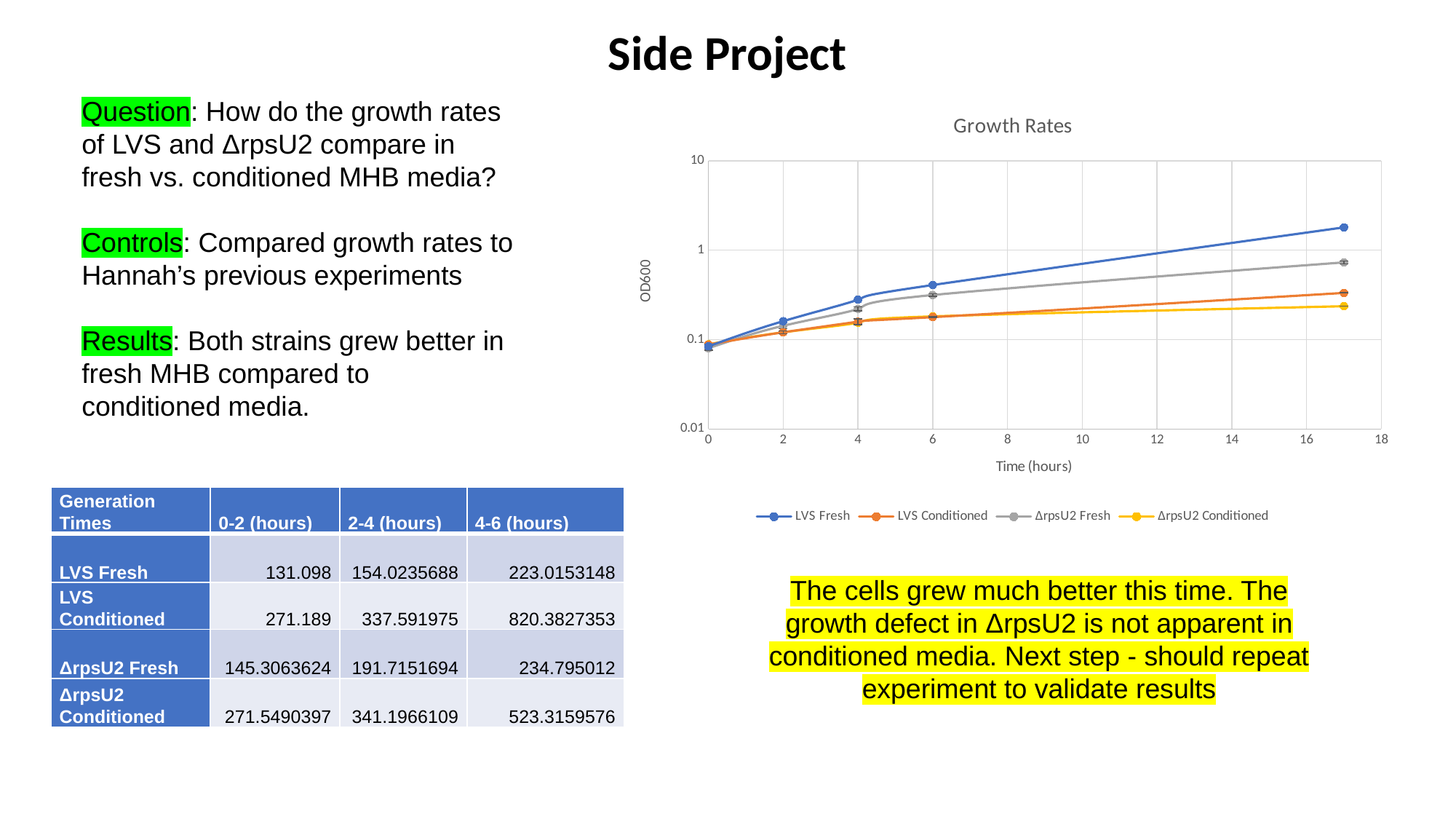
Is the OD600 value for LVS Conditioned at 6 hours greater or less than 0.1? greater What is the title of the chart on the slide? Growth Rates Is the OD600 value for ΔrpsU2 Fresh at 17 hours greater or less than 1? less What kind of chart is shown on the slide? line chart Do the OD600 values for LVS Fresh rise or fall as time increases in the Growth Rates chart? rise At 17 hours, which series has the larger OD600 value: LVS Fresh or ΔrpsU2 Fresh? LVS Fresh Is the OD600 value for LVS Fresh at 17 hours greater or less than 1? greater How many time points are plotted for each series in the Growth Rates chart? 5 What is the label of the y axis of the Growth Rates chart? OD600 Which series has the highest OD600 value at 17 hours in the Growth Rates chart? LVS Fresh Which series has the lowest OD600 value at 17 hours in the Growth Rates chart? ΔrpsU2 Conditioned How many series does the legend of the Growth Rates chart list? 4